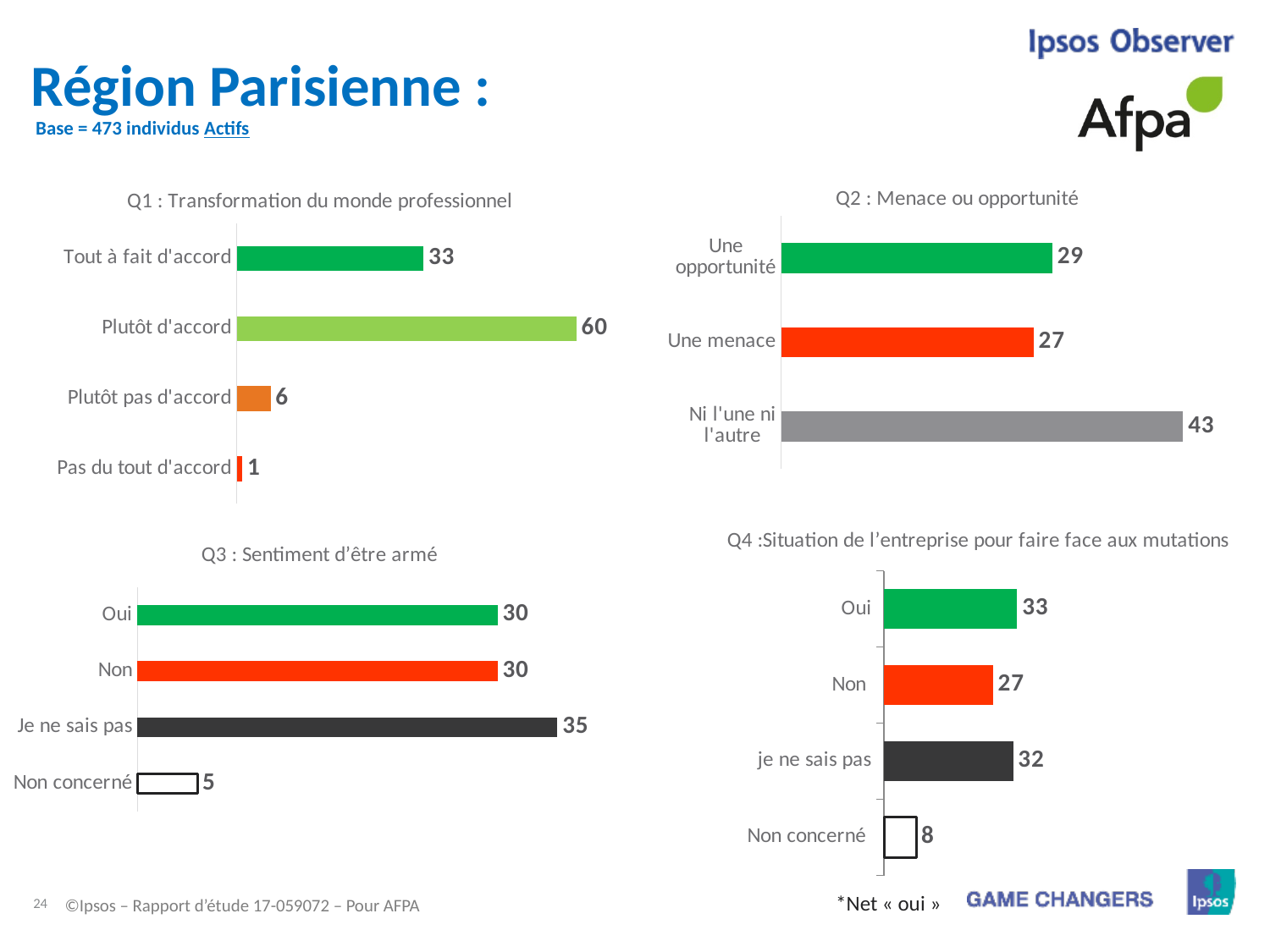
In the chart titled "Q3 : Sentiment d'être armé", which category has the lowest value? Non concerné In the chart titled "Q1 : Transformation du monde professionnel", what is the difference between "Plutôt d'accord" and "Tout à fait d'accord"? 27 In the chart titled "Q2 : Menace ou opportunité", how many categories are shown? 3 In the chart titled "Q2 : Menace ou opportunité", what is the value for "Une menace"? 27 In the chart titled "Q3 : Sentiment d'être armé", what is the value for "Je ne sais pas"? 35 In the chart titled "Q1 : Transformation du monde professionnel", what is the value for "Plutôt d'accord"? 60 In the chart titled "Q4 :Situation de l'entreprise pour faire face aux mutations", which is larger, "Oui" or "Non"? Oui In the chart titled "Q4 :Situation de l'entreprise pour faire face aux mutations", how many categories are shown? 4 What kind of chart is the chart titled "Q1 : Transformation du monde professionnel"? Bar chart In the chart titled "Q2 : Menace ou opportunité", which category has the highest value? Ni l'une ni l'autre In the chart titled "Q4 :Situation de l'entreprise pour faire face aux mutations", what is the value for "Non concerné"? 8 In the chart titled "Q1 : Transformation du monde professionnel", which category has the lowest value? Pas du tout d'accord